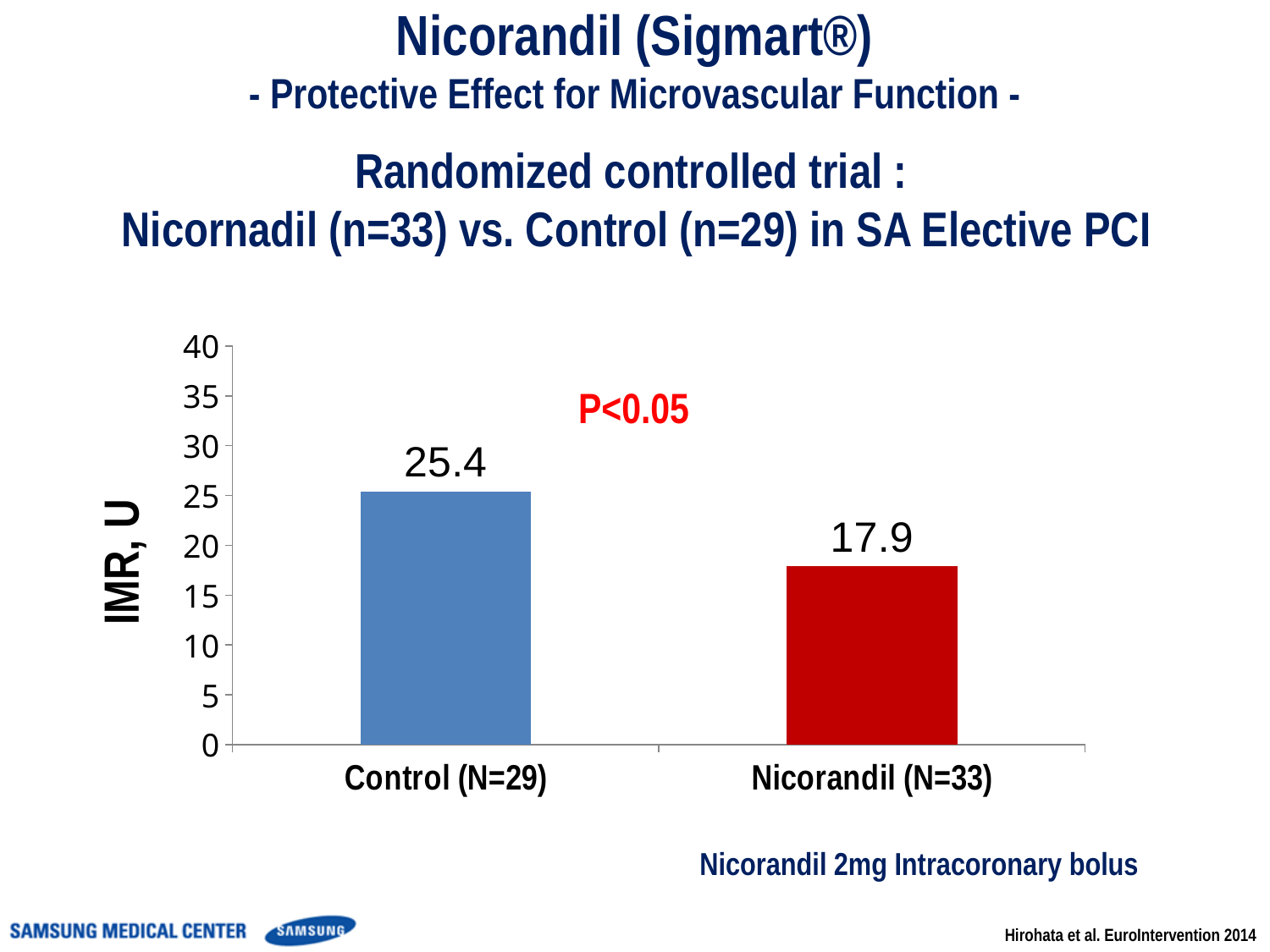
Is the value for Control (N=29) greater or less than 25? greater What is the label of the y axis? IMR, U How many groups are plotted in the chart? 2 What p-value is shown on the chart? P<0.05 What kind of chart is shown on the slide? bar chart What is the IMR value for Nicorandil (N=33)? 17.9 What is the IMR value for Control (N=29)? 25.4 Which group has the lower IMR value? Nicorandil (N=33) What is the difference in IMR between Control (N=29) and Nicorandil (N=33)? 7.5 Is the value for Nicorandil (N=33) greater or less than 20? less Is the IMR value for Control (N=29) larger or smaller than that for Nicorandil (N=33)? larger Which group has the higher IMR value? Control (N=29)